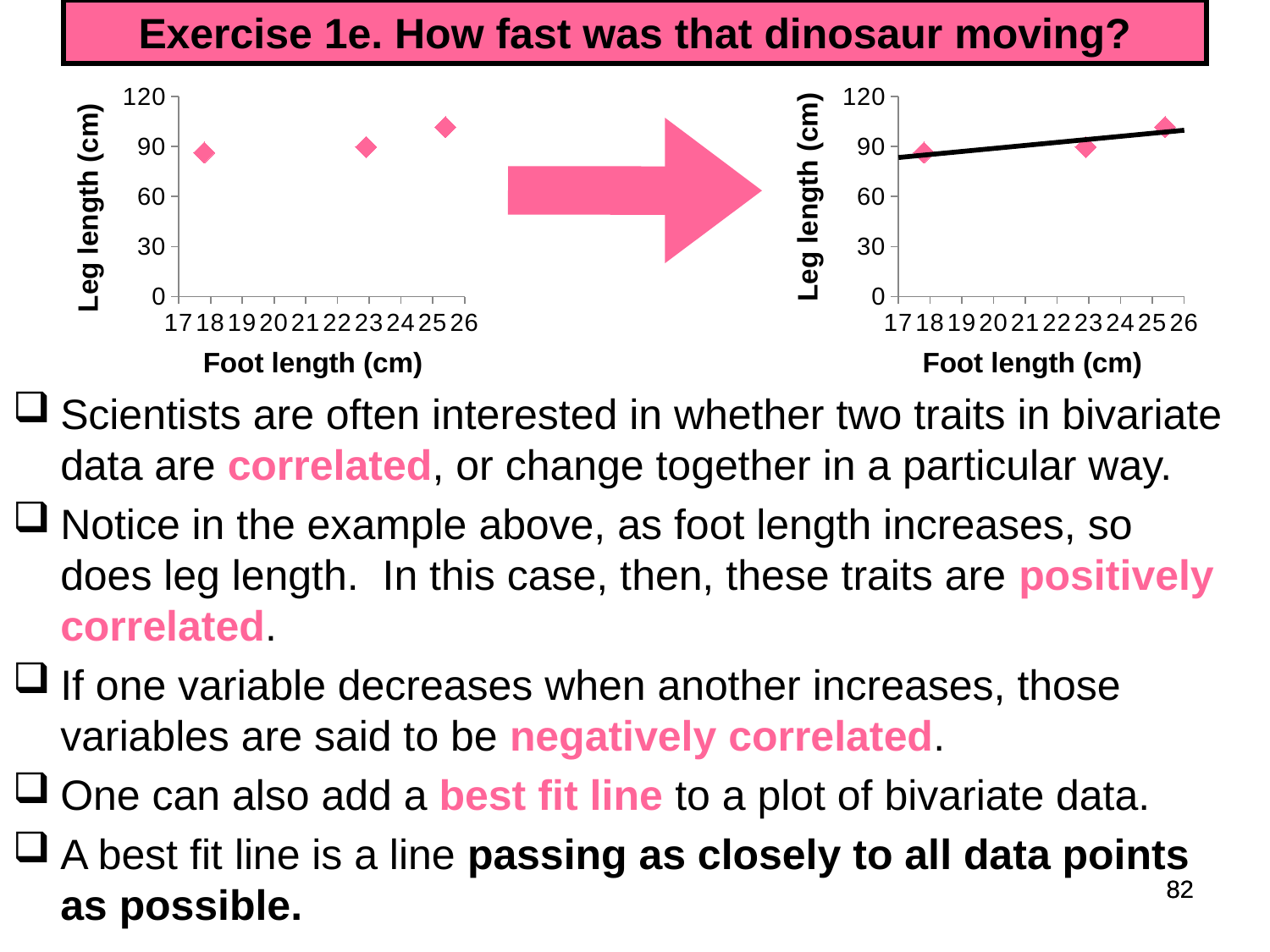
How many data points are plotted on the left chart? 3 On the left chart, do the leg length values rise or fall as foot length increases? rise What kind of chart is the right chart on the slide? scatter chart What is the label of the y axis on the left chart? Leg length (cm) On the right chart, are all plotted leg length values greater or less than 120? less What has been added to the right chart that is not on the left chart? a best fit line On the left chart, is the leg length of the point with the smallest foot length greater or less than 60? greater On the left chart, which point has the highest leg length: the one with the smallest foot length or the one with the largest foot length? the one with the largest foot length How many data points are plotted on the right chart? 3 What kind of chart is the left chart on the slide? scatter chart On the left chart, is the leg length of the point with the largest foot length greater or less than 90? greater On the right chart, does the best fit line slope upward or downward as foot length increases? upward